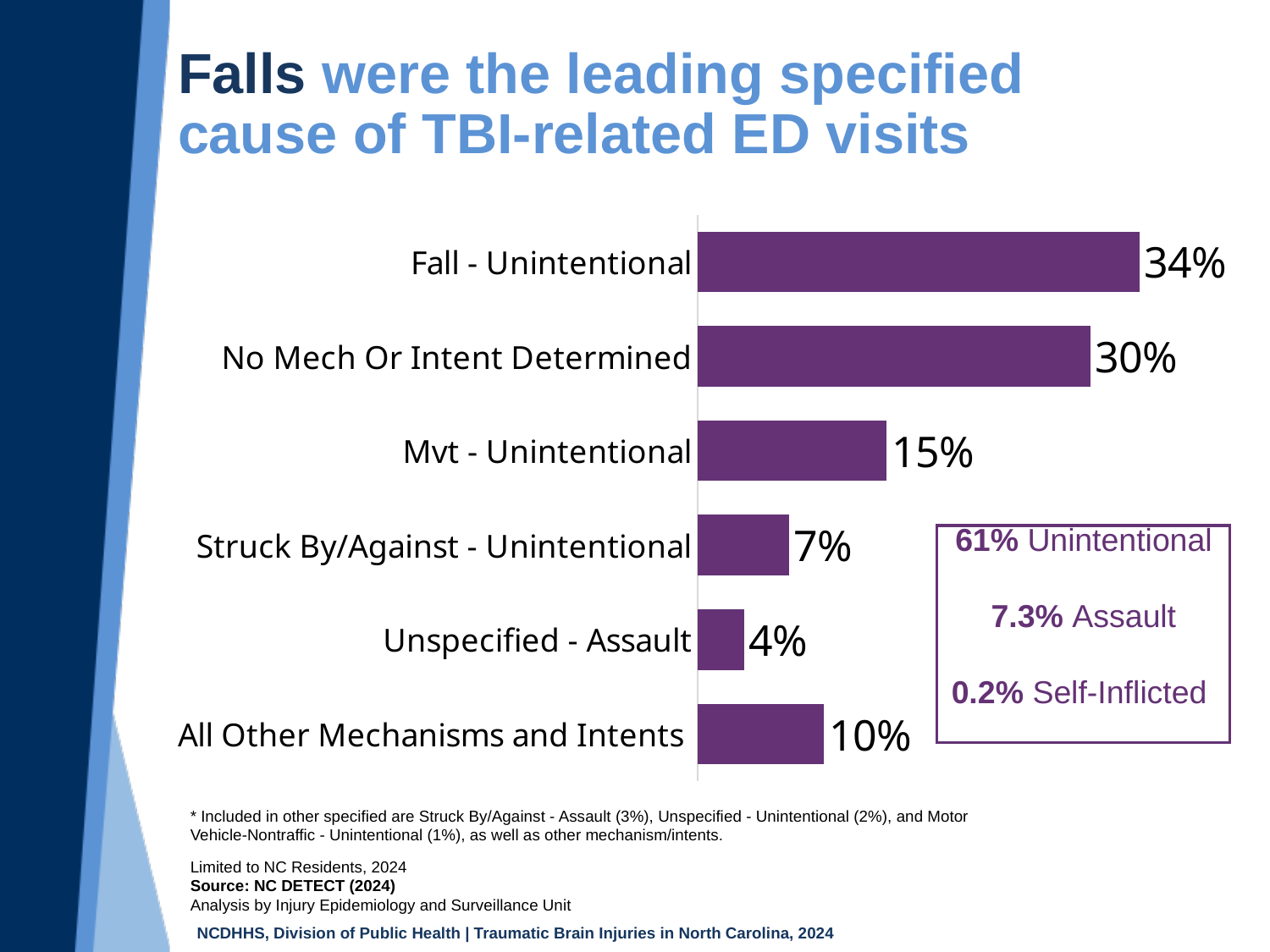
What is the value for Fall - Unintentional? 34% What is the value for Mvt - Unintentional? 15% What kind of chart is shown on the slide? Bar chart Which category has the highest value? Fall - Unintentional What is the difference between Fall - Unintentional and No Mech Or Intent Determined? 4% How many categories are shown in the chart? 6 Which is larger, All Other Mechanisms and Intents or Struck By/Against - Unintentional? All Other Mechanisms and Intents What is the value for No Mech Or Intent Determined? 30% What is the difference between Mvt - Unintentional and Struck By/Against - Unintentional? 8% What is the value for Unspecified - Assault? 4% According to the text box beside the chart, what percentage of visits were Unintentional? 61% Which category has the lowest value? Unspecified - Assault